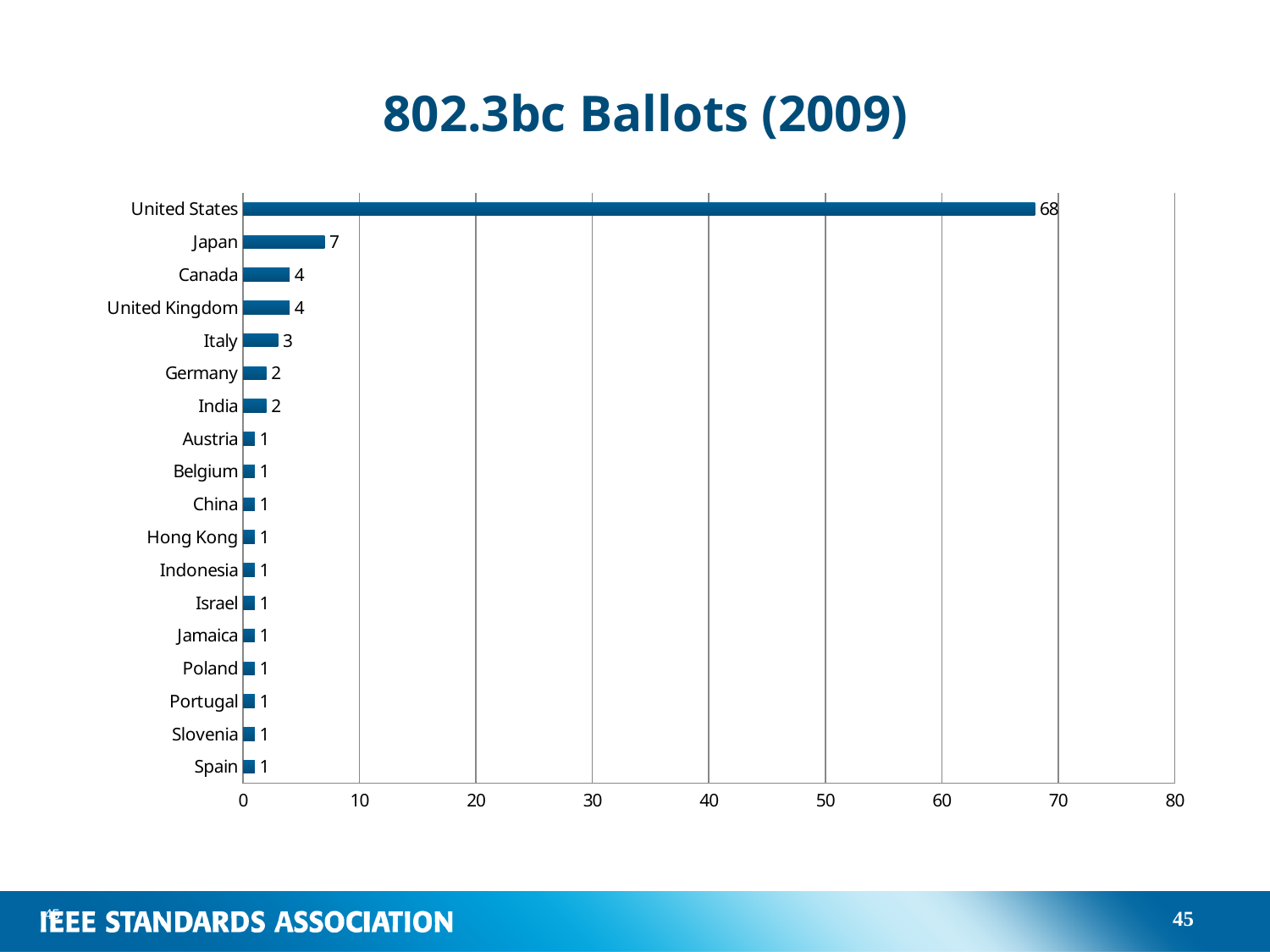
What kind of chart is shown on the slide? Bar chart What is the difference between the values for Japan and Canada? 3 Is the value for the United States greater or less than 60? greater What is the title of the chart? 802.3bc Ballots (2009) What is the maximum value shown on the horizontal axis? 80 How many countries are listed on the chart? 18 What is the value shown for Japan? 7 Which country has the highest number of ballots? United States How many ballots does the chart show for the United States? 68 Which has a larger value, Italy or Germany? Italy What is the difference between the values for the United States and Japan? 61 What is the value shown for Italy? 3